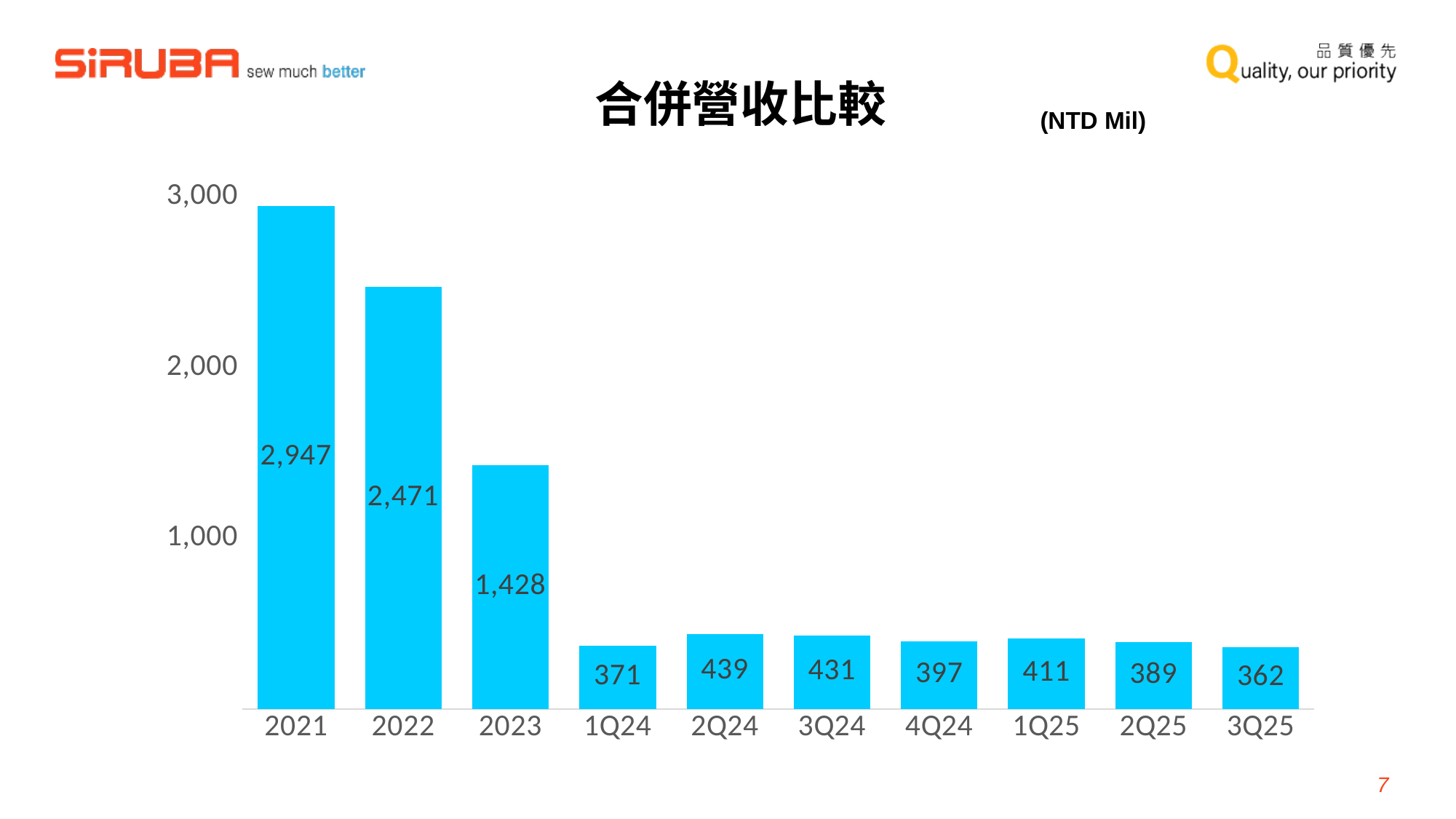
Which category has the highest value? 2021 Is the value for 2023 greater or less than 2,000? less What is the value for 2Q25? 389 Which is larger, the value for 1Q25 or the value for 4Q24? 1Q25 What is the difference between the values for 2021 and 2022? 476 What kind of chart is shown on the slide? bar chart What is the value for 3Q24? 431 What is the value for 2021? 2,947 Which category has the lowest value? 3Q25 What unit is indicated next to the chart title? NTD Mil What is the difference between the values for 2Q24 and 3Q25? 77 How many categories are shown on the x axis? 10